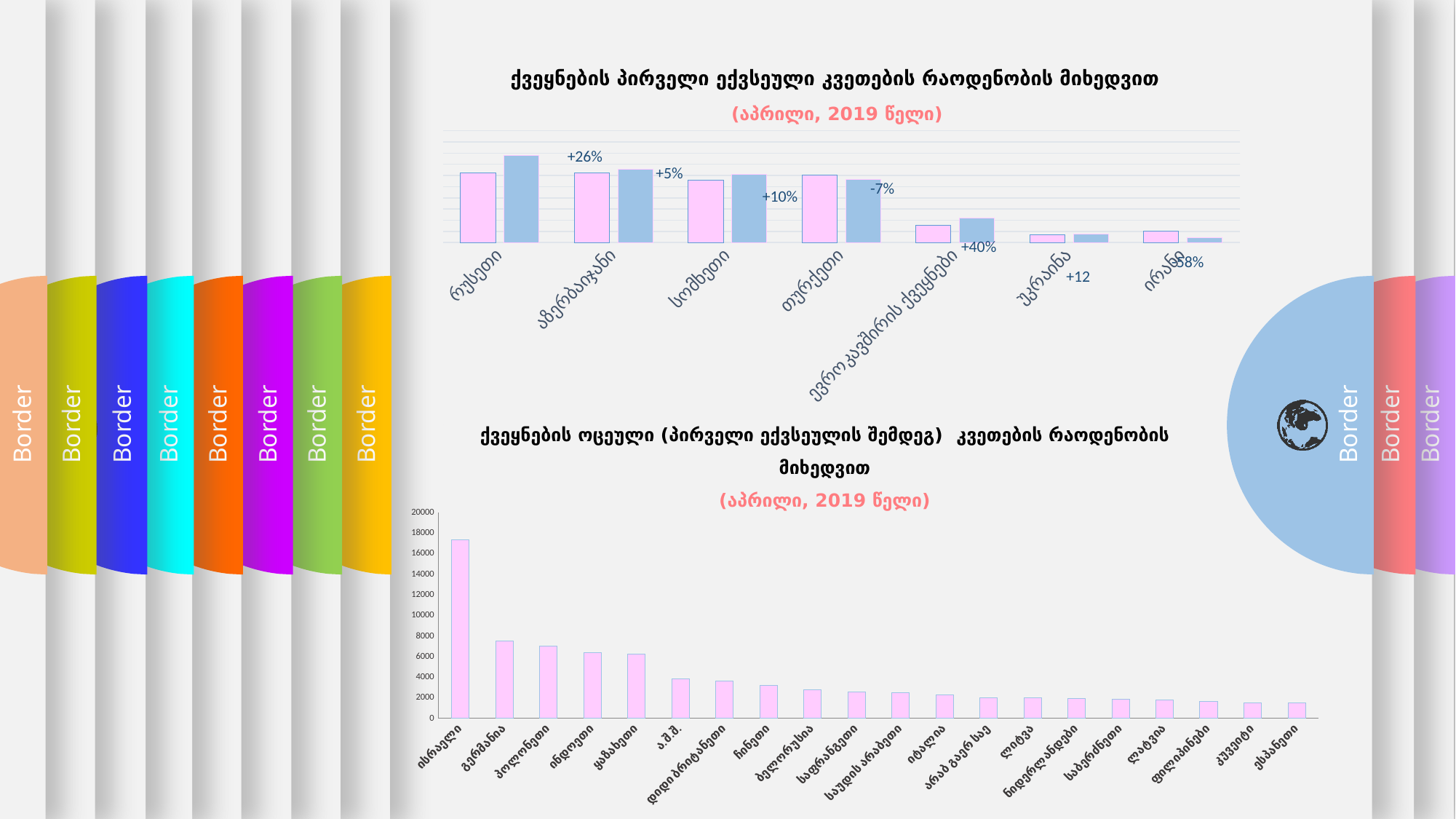
On the bottom chart (ქვეყნების ოცეული), which country has the highest value? ისრაელი On the bottom chart (ქვეყნების ოცეული), is the value for გერმანია greater or less than 6000? greater How many countries are shown on the bottom chart (ქვეყნების ოცეული)? 20 What period is given in the subtitle of the top chart? (აპრილი, 2019 წელი) On the bottom chart (ქვეყნების ოცეული), is the value for ისრაელი greater or less than 16000? greater On the top chart (ქვეყნების პირველი ექვსეული), what percentage change is labelled for ევროკავშირის ქვეყნები? +40% On the bottom chart (ქვეყნების ოცეული), do the values rise or fall from left to right along the x axis? fall On the top chart (ქვეყნების პირველი ექვსეული), what percentage change is labelled for რუსეთი? +26% On the top chart (ქვეყნების პირველი ექვსეული), what percentage change is labelled for ირანი? -58% What kind of chart is the bottom chart (ქვეყნების ოცეული)? bar chart How many countries are shown on the top chart (ქვეყნების პირველი ექვსეული)? 7 On the bottom chart (ქვეყნების ოცეული), is the value for ჩინეთი greater or less than 4000? less